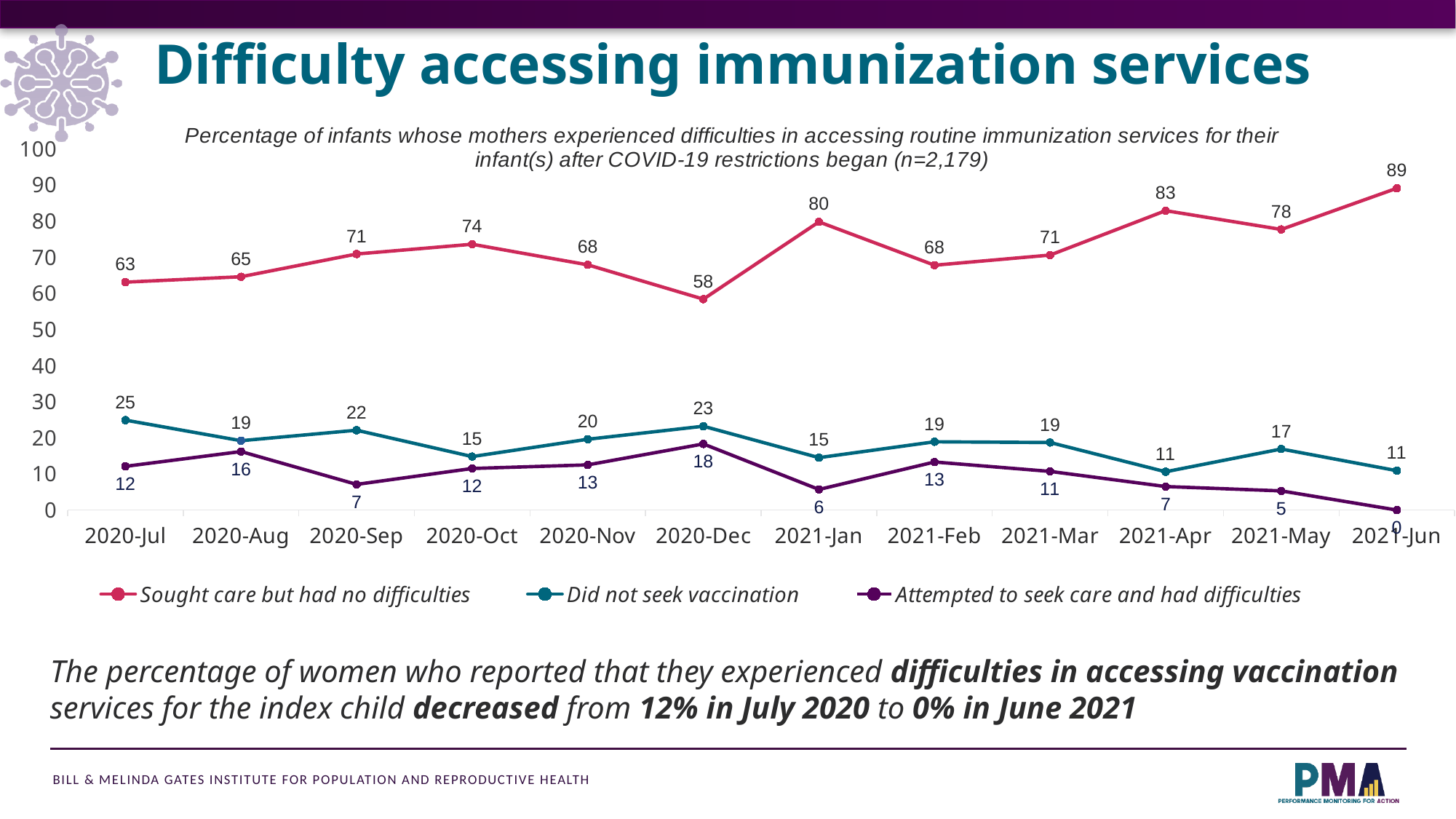
What is the value for 'Attempted to seek care and had difficulties' in 2020-Dec? 18 How many months are plotted along the x axis? 12 In which month is 'Sought care but had no difficulties' highest? 2021-Jun Does 'Attempted to seek care and had difficulties' rise or fall from 2021-Feb to 2021-Jun? Fall What is the value for 'Sought care but had no difficulties' in 2021-Jan? 80 What kind of chart is shown on the slide? Line chart In which month is 'Sought care but had no difficulties' lowest? 2020-Dec How many series does the legend list? 3 What colour is the line for 'Did not seek vaccination'? Teal What is the value for 'Did not seek vaccination' in 2020-Sep? 22 Which is larger in 2020-Aug: 'Did not seek vaccination' or 'Attempted to seek care and had difficulties'? Did not seek vaccination What is the difference between the 'Sought care but had no difficulties' values in 2021-Jun and 2020-Jul? 26